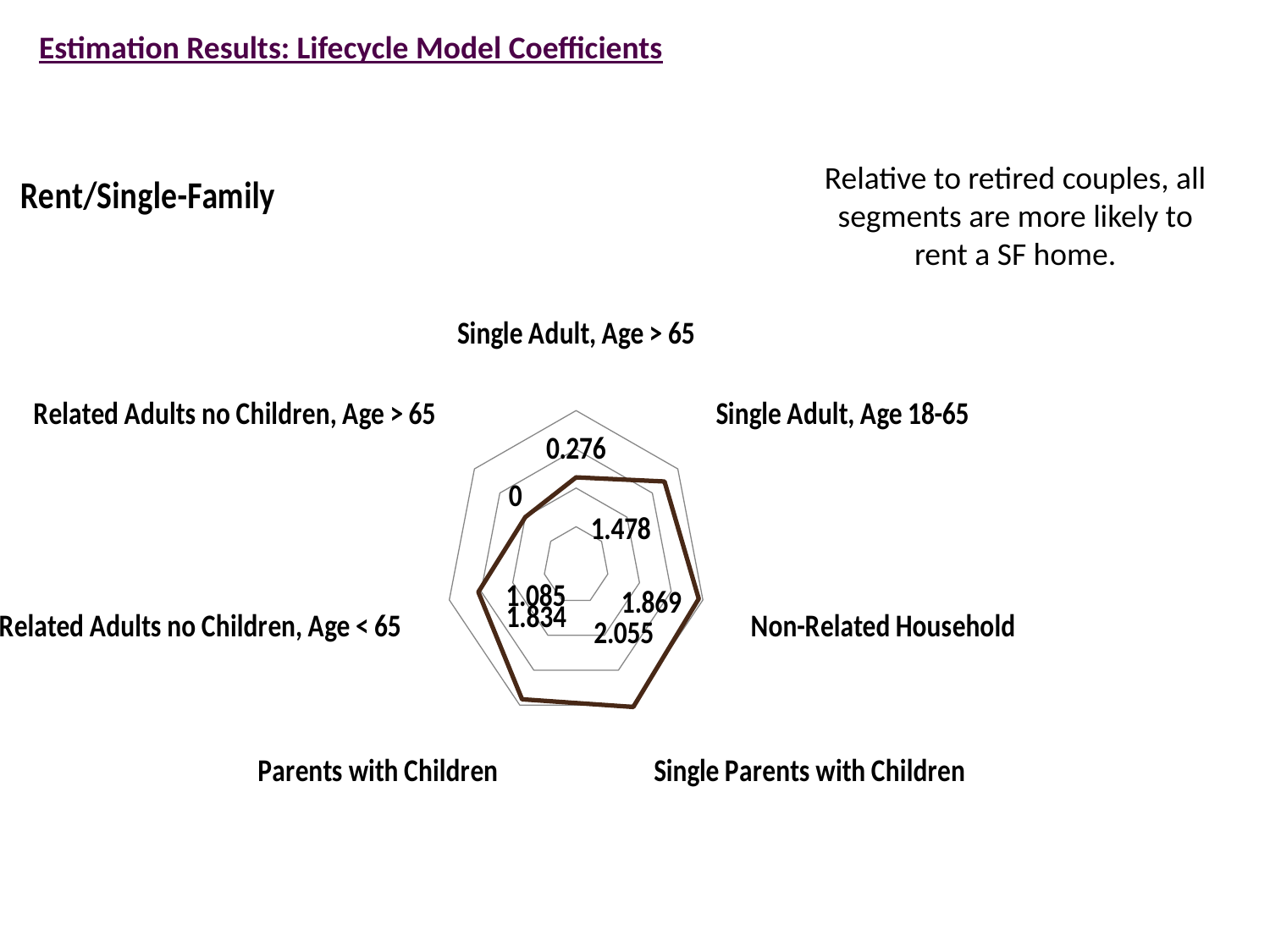
What kind of chart is shown on the slide? Radar chart Which is larger, the value for Single Parents with Children or the value for Single Adult, Age > 65? Single Parents with Children What is the coefficient value shown for Non-Related Household? 1.869 Which segment has the lowest coefficient value on the chart? Related Adults no Children, Age > 65 What is the title of the chart? Rent/Single-Family What is the largest data label value printed on the chart? 2.055 What is the coefficient value shown for Related Adults no Children, Age > 65? 0 How many lifecycle segments (categories) are plotted on the radar chart? 7 Which segment has the highest coefficient value on the chart? Single Parents with Children What is the coefficient value shown for Single Adult, Age > 65? 0.276 What is the coefficient value shown for Single Parents with Children? 2.055 What is the difference between the value for Single Parents with Children (2.055) and the value for Single Adult, Age > 65 (0.276)? 1.779